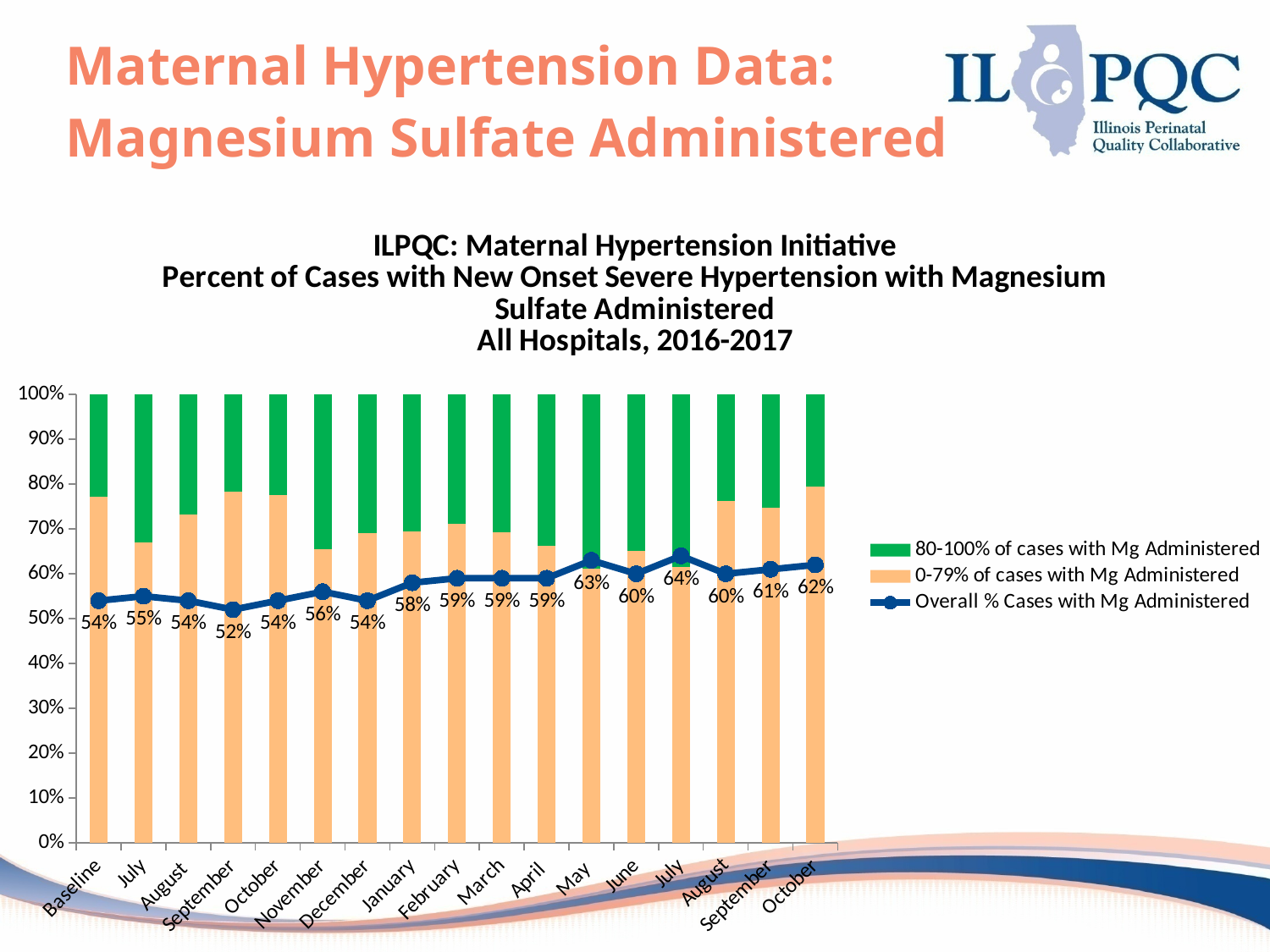
Which month has the lowest Overall % Cases with Mg Administered? September (the first September, 52%) Does the Overall % Cases with Mg Administered generally rise or fall from Baseline to the final October? rise How many time periods are shown on the x axis? 17 Is the value of the 0-79% of cases with Mg Administered bar at Baseline greater or less than 70%? greater What is the Overall % Cases with Mg Administered in May? 63% What is the Overall % Cases with Mg Administered in January? 58% How many series does the legend list? 3 Which is larger, the Overall % Cases with Mg Administered in November or in June? June What is the Overall % Cases with Mg Administered at Baseline? 54% Is the value of the 0-79% of cases with Mg Administered bar in May greater or less than 70%? less What is the difference between the Overall % Cases with Mg Administered in May and at Baseline? 9 percentage points Which month has the highest Overall % Cases with Mg Administered? July (the second July, 64%)